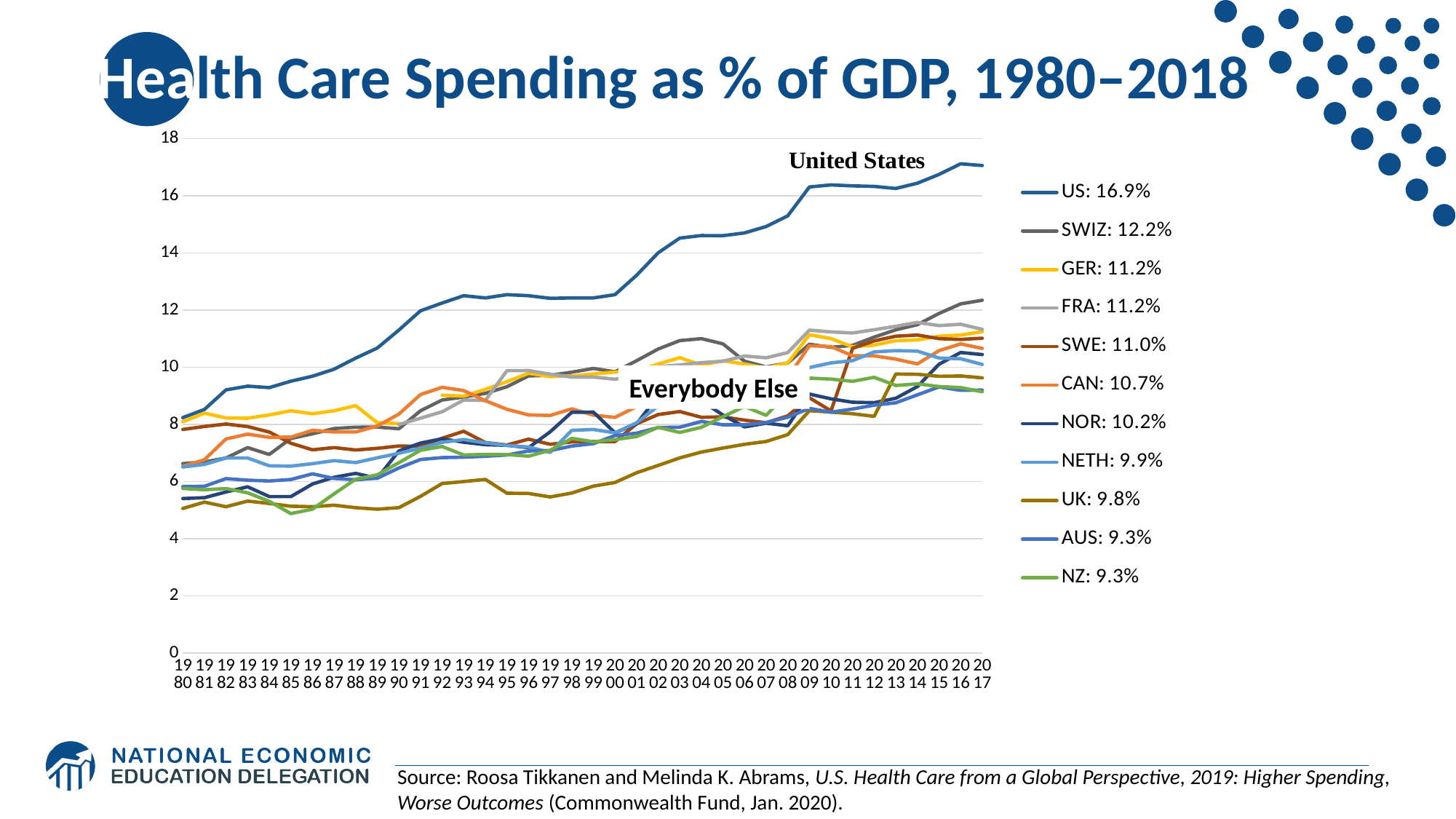
What value does the legend give for the US? 16.9% What value does the legend give for the UK? 9.8% Does the US line rise or fall from 1980 to 2017? rises What is the difference between the legend values for the US and SWIZ? 4.7 percentage points Which has the larger legend value, CAN or NOR? CAN Is the value for the US line in 2017 greater or less than 16? greater Is the value for the US line in 1980 greater or less than 10? less How many series does the legend list? 11 What value does the legend give for SWIZ? 12.2% What kind of chart is shown on the slide? line chart Which country has the highest value in the legend? US What are the two text annotations placed on the plot area? United States and Everybody Else